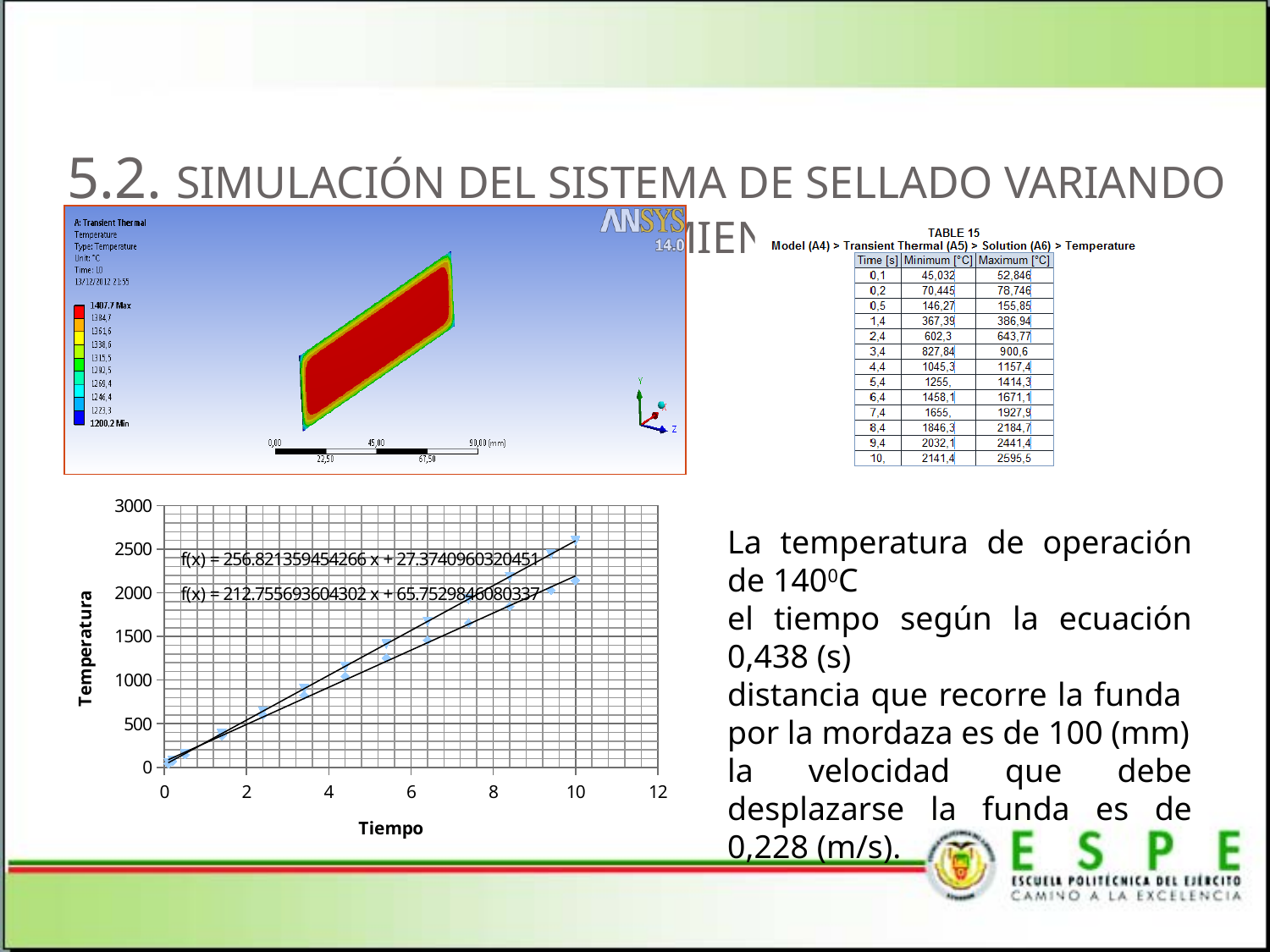
How many trend lines are plotted in the bottom-left chart? 2 What kind of chart is shown at the bottom left of the slide? scatter chart What is the intercept in the second (lower) trend line equation shown in the bottom-left chart? 65.7529846080337 In the bottom-left chart, is the value of the upper series at Tiempo 10 greater or less than 2000? greater What is the title of the horizontal axis of the bottom-left chart? Tiempo In the bottom-left chart, are the plotted values at Tiempo 2 greater or less than 1000? less What is the highest tick value shown on the vertical axis of the bottom-left chart? 3000 In the bottom-left chart, do the temperature values rise or fall as Tiempo increases? rise In the bottom-left chart, is the value of the lower series at Tiempo 10 greater or less than 2000? greater What is the title of the vertical axis of the bottom-left chart? Temperatura What is the slope in the first (upper) trend line equation shown in the bottom-left chart? 256.821359454266